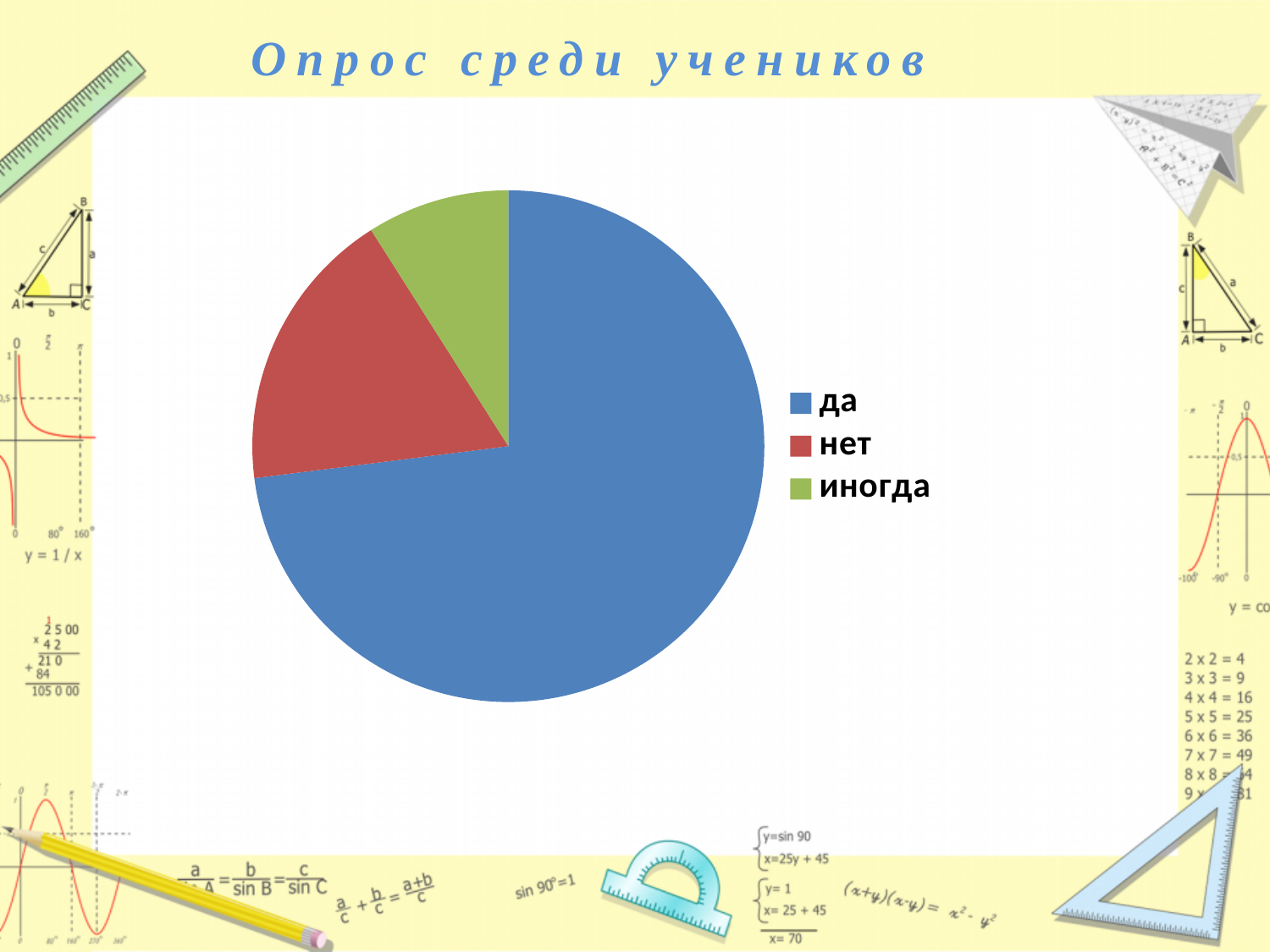
Which category has the largest slice in the pie chart? да How many entries does the legend of the pie chart list? 3 Which category has the smallest slice in the pie chart? иногда How many slices does the pie chart have? 3 Does the "да" slice take up more or less than half of the pie chart? more What is the title shown above the pie chart on the slide? Опрос среди учеников Which slice is larger in the pie chart, "да" or "нет"? да What kind of chart is shown on the slide? pie chart Which slice is larger in the pie chart, "нет" or "иногда"? нет What colour is the "нет" slice in the pie chart? red